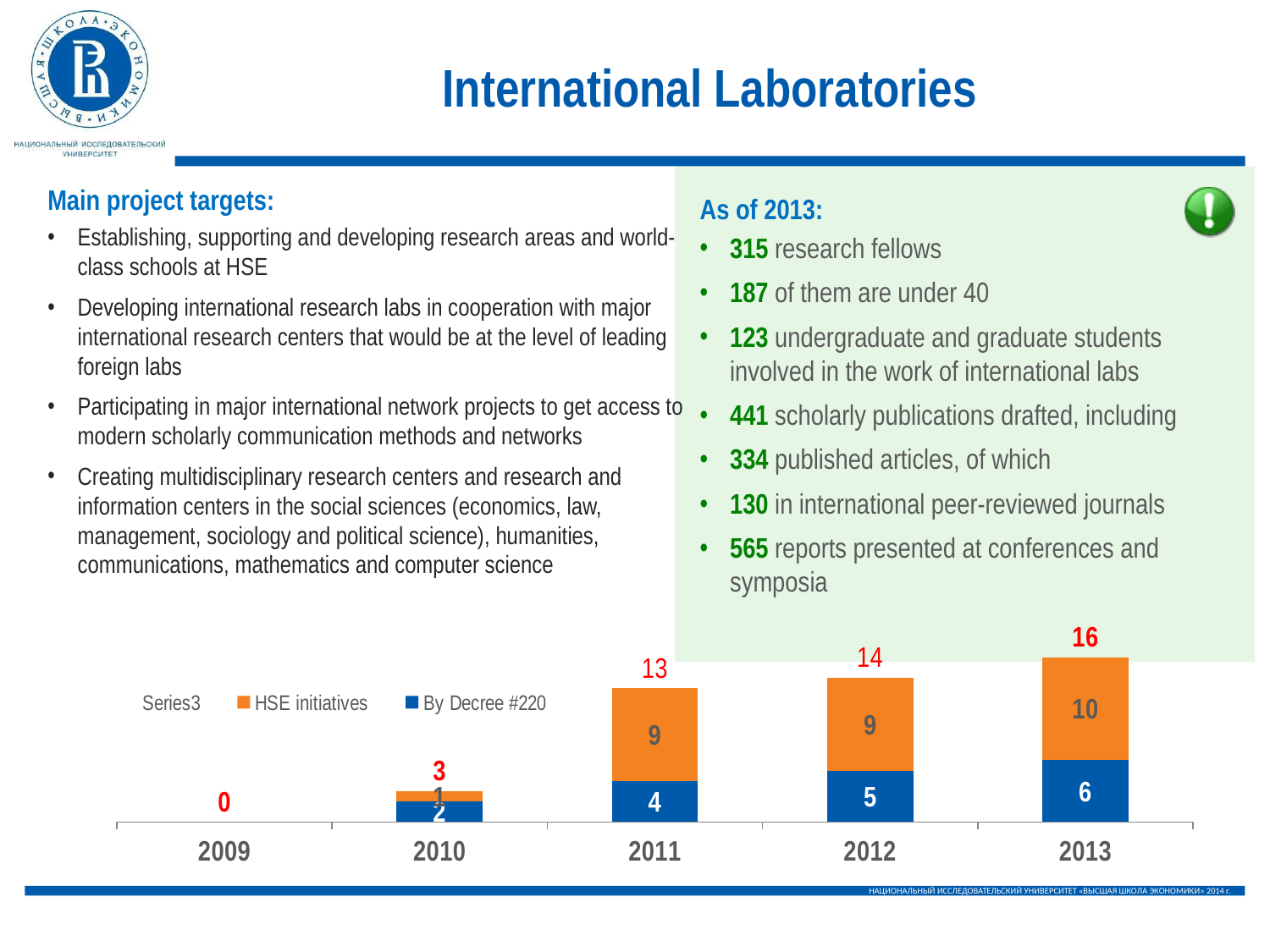
Do the totals rise or fall from 2009 to 2013? Rise What is the total shown above the bar for 2012? 14 What is the value for HSE initiatives in 2011? 9 Which year has the highest total? 2013 How many years are shown on the x axis? 5 Which is larger in 2012: HSE initiatives or By Decree #220? HSE initiatives How many entries does the legend list? 3 What kind of chart is shown on the slide? Stacked bar chart What colour represents HSE initiatives in the chart? Orange What is the difference between the totals for 2013 and 2011? 3 Which year has the lowest total? 2009 What is the value for By Decree #220 in 2013? 6